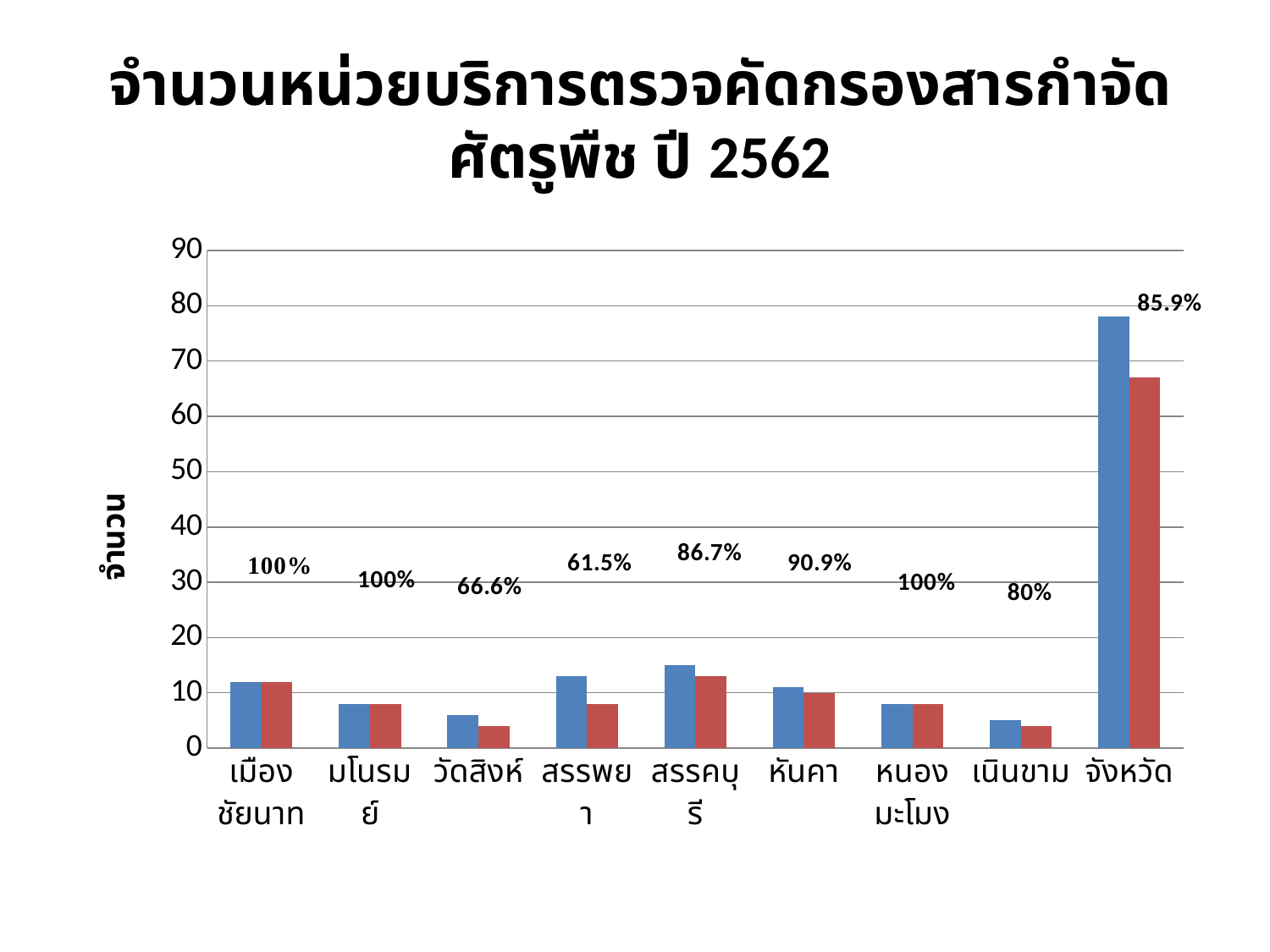
What percentage label is printed above the bars for วัดสิงห์? 66.6% Is the value of the red bar for จังหวัด greater or less than 70? less What percentage label is printed above the bars for สรรพยา? 61.5% For สรรคบุรี, which bar is taller, the blue bar or the red bar? the blue bar Is the value of the blue bar for จังหวัด greater or less than 70? greater What kind of chart is shown on the slide? bar chart What is the label on the vertical axis of the chart? จำนวน What percentage label is printed above the bars for เนินขาม? 80% What percentage label is printed above the bars for จังหวัด? 85.9% How many categories are shown on the x axis of the chart? 9 Which category has the tallest bars in the chart? จังหวัด What percentage label is printed above the bars for หันคา? 90.9%